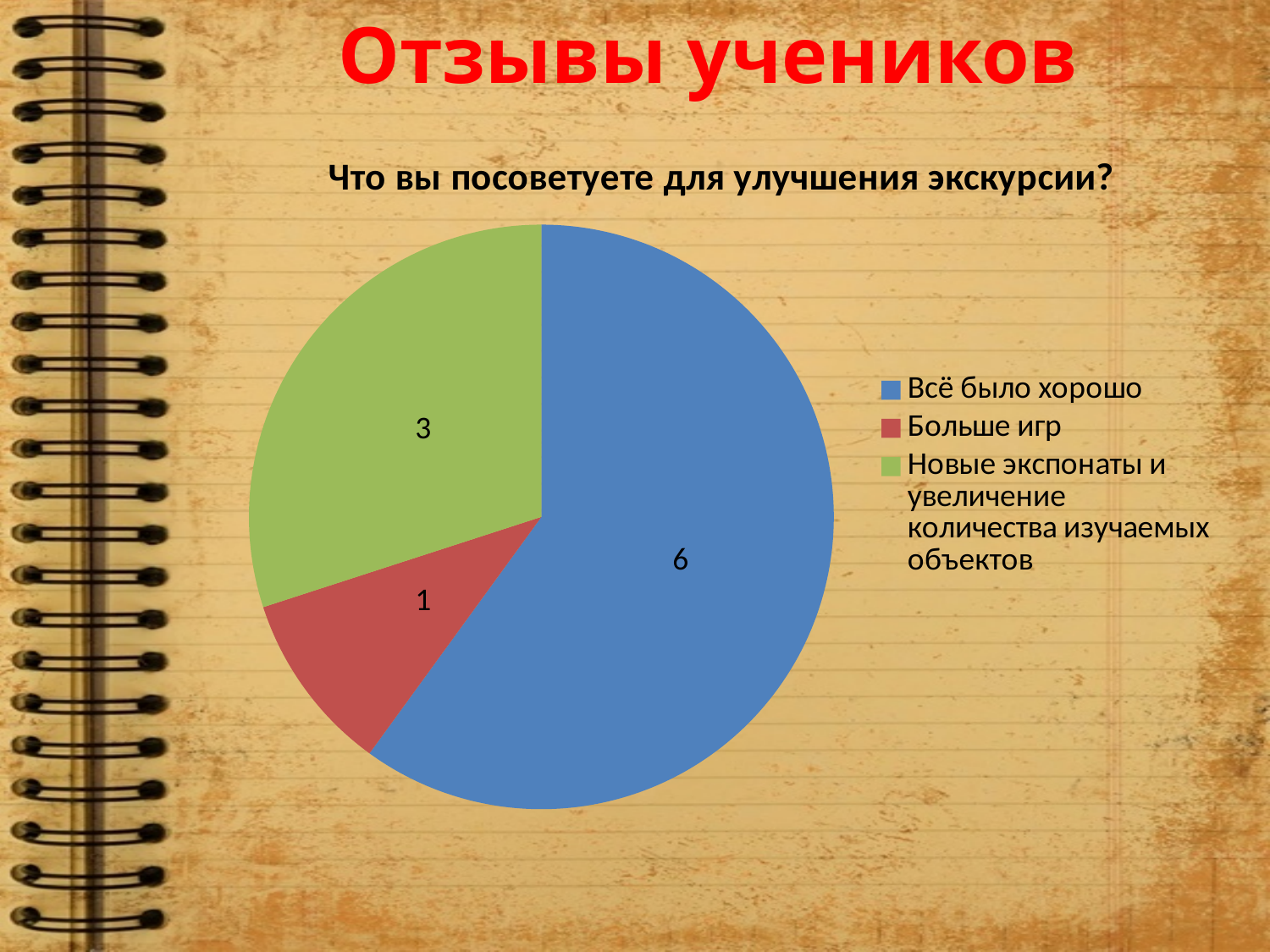
What is the difference between the values for "Всё было хорошо" and "Больше игр"? 5 Which is larger, the value for "Новые экспонаты и увеличение количества изучаемых объектов" or the value for "Больше игр"? Новые экспонаты и увеличение количества изучаемых объектов Which category has the largest slice? Всё было хорошо What is the total of all slices in the pie chart? 10 What type of chart is shown on the slide? pie chart What is the value for "Всё было хорошо"? 6 What is the value for "Новые экспонаты и увеличение количества изучаемых объектов"? 3 How many categories does the pie chart have? 3 What share of the pie does "Всё было хорошо" represent? 60% What is the title of the chart? Что вы посоветуете для улучшения экскурсии? Which category has the smallest slice? Больше игр What is the value for "Больше игр"? 1